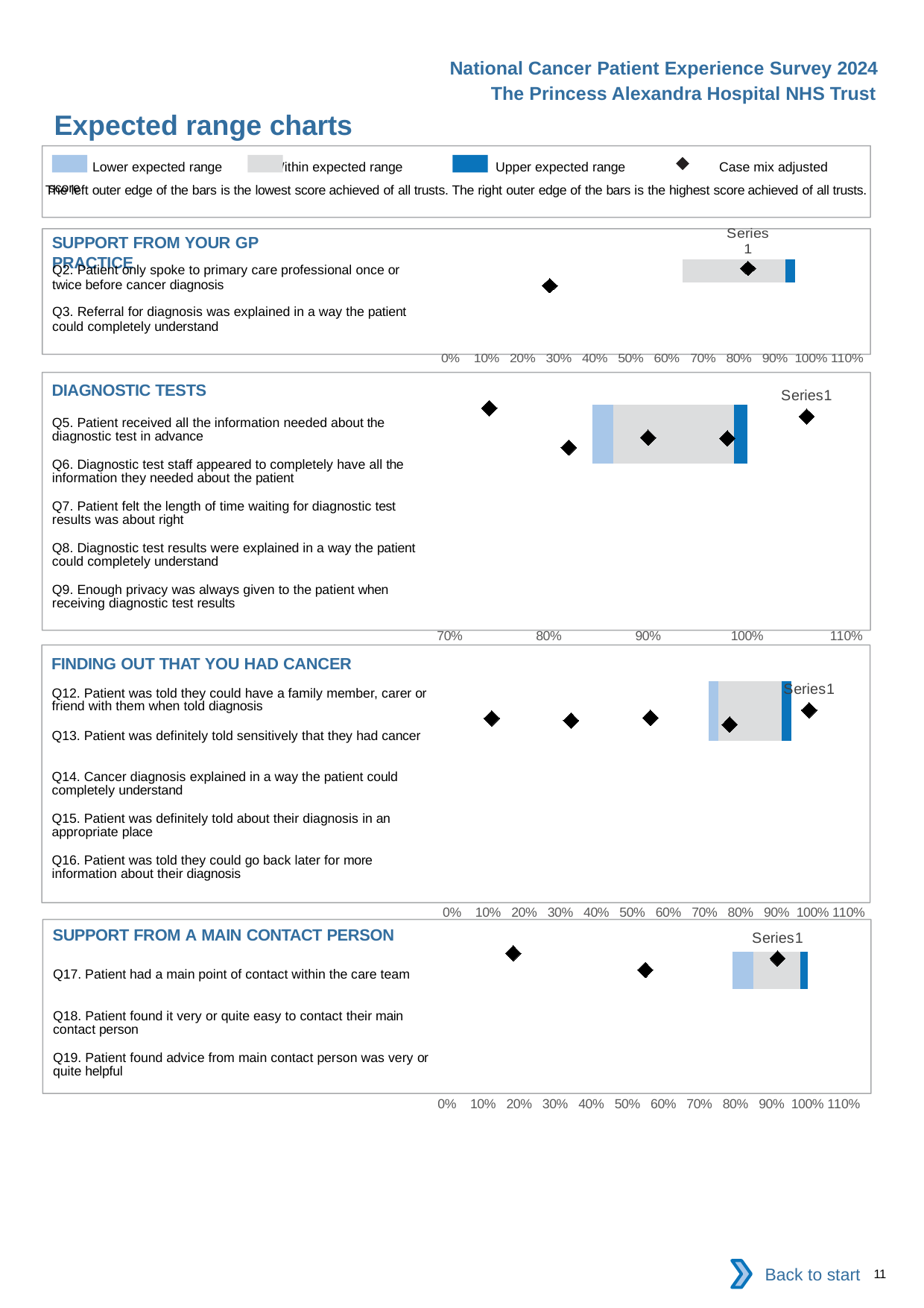
How many questions are listed in the 'FINDING OUT THAT YOU HAD CANCER' chart? 5 How many series does the legend inside the 'DIAGNOSTIC TESTS' chart list? 1 How many entries does the key at the top of the slide list? 4 What kind of chart is used in the 'DIAGNOSTIC TESTS' section? bar chart In the 'DIAGNOSTIC TESTS' chart, are all the case mix adjusted score markers greater or less than 70%? greater What is the lowest value shown on the x axis of the 'DIAGNOSTIC TESTS' chart? 70% How many expected range charts are shown on the slide? 4 How many questions are listed in the 'DIAGNOSTIC TESTS' chart? 5 What does the diamond marker represent according to the key at the top of the slide? Case mix adjusted score